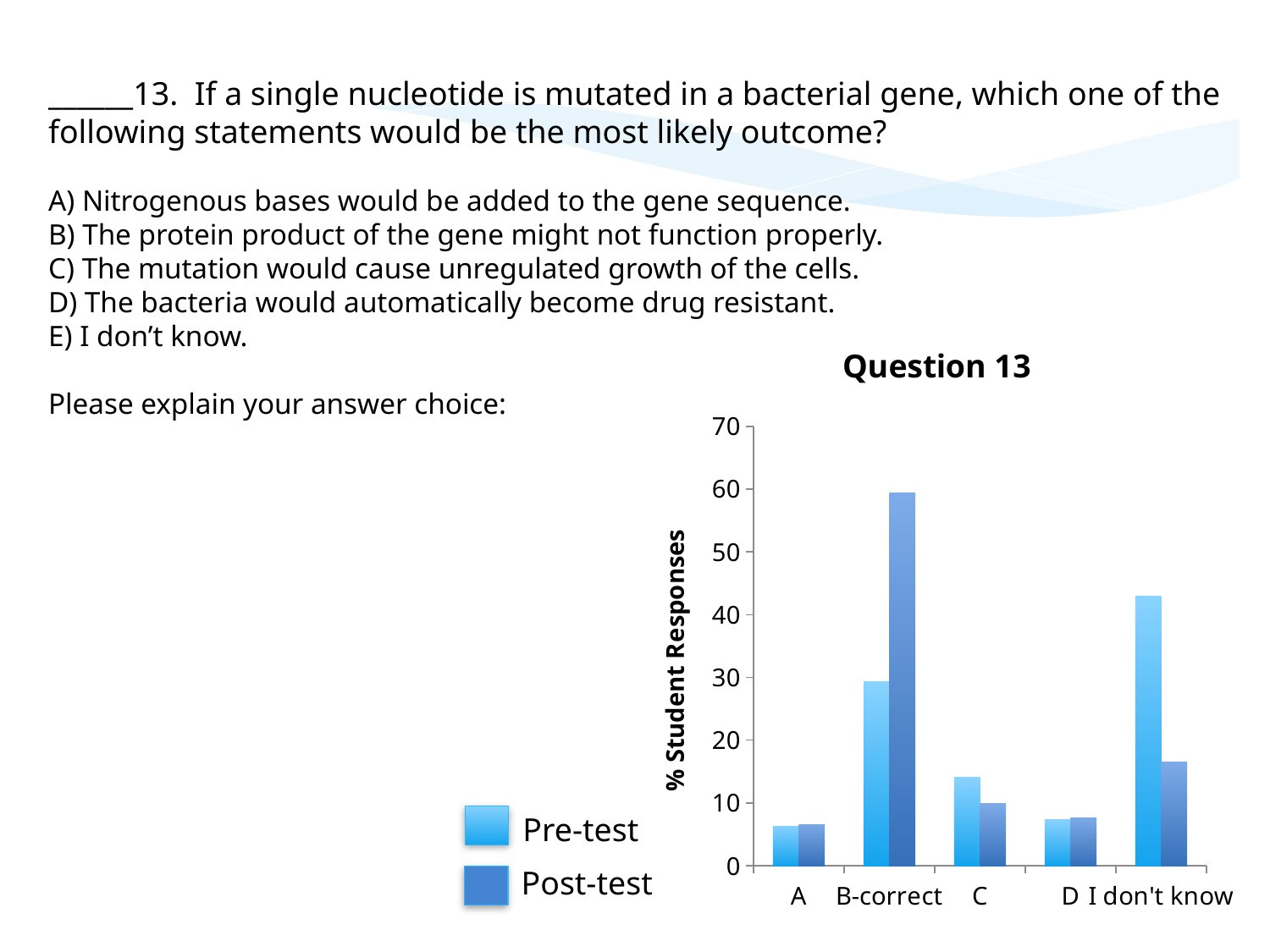
Is the Post-test value for B-correct greater or less than 50? greater How many series does the legend list? 2 Is the Pre-test value for B-correct greater or less than 40? less For I don't know, which is larger, the Pre-test or the Post-test value? Pre-test How many categories are shown on the x axis of the chart? 5 Which category has the highest Pre-test value? I don't know For B-correct, which is larger, the Pre-test or the Post-test value? Post-test Which category has the highest Post-test value? B-correct Is the Pre-test value for I don't know greater or less than 40? greater What kind of chart is shown on the slide? bar chart What is the title of the chart? Question 13